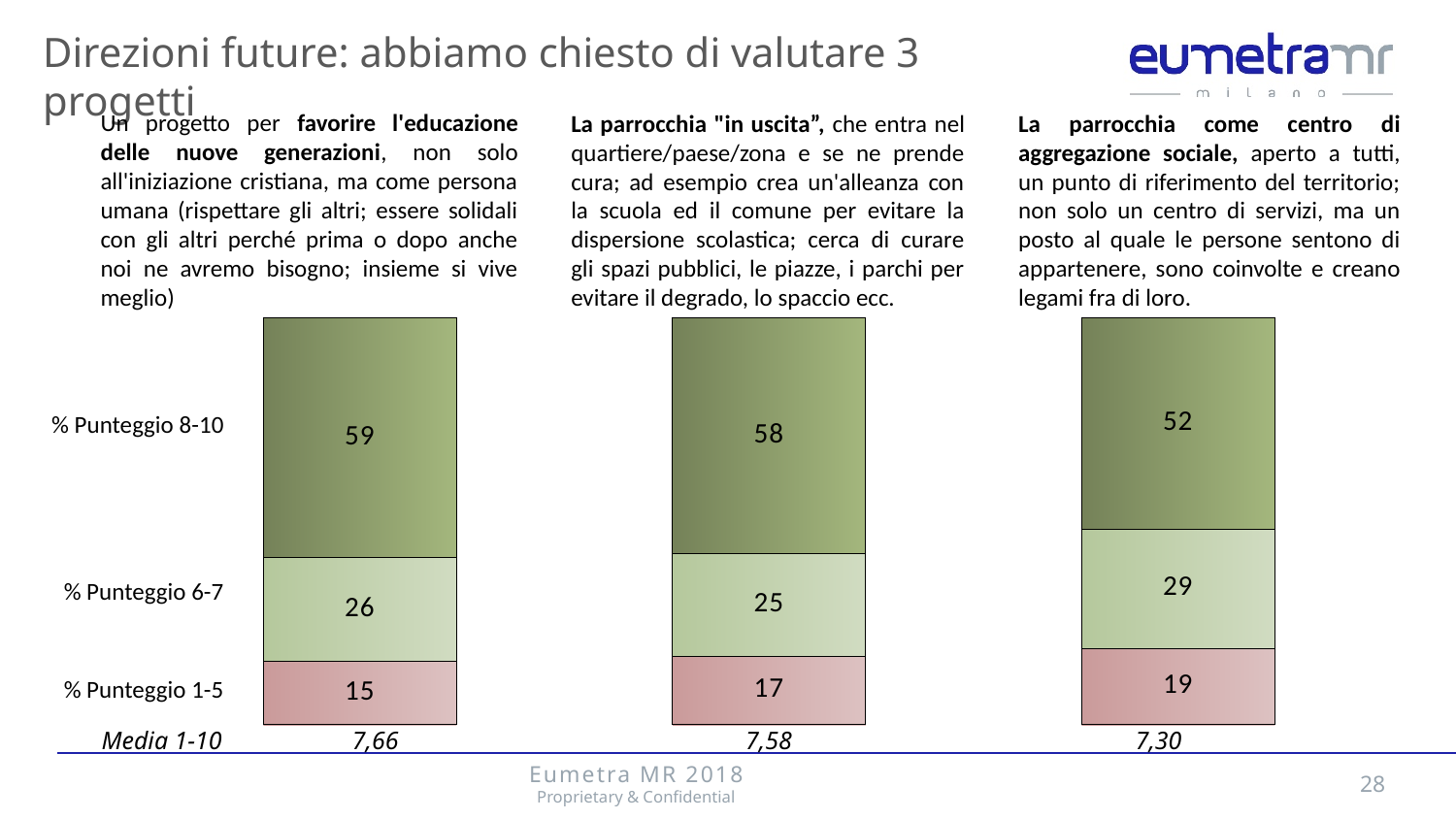
In the left chart, what is the difference between % Punteggio 8-10 and % Punteggio 6-7? 33 Across the three charts, which project has the highest % Punteggio 8-10? Un progetto per favorire l'educazione delle nuove generazioni (59) What is the difference between the % Punteggio 8-10 value in the left chart and in the right chart? 7 Is the % Punteggio 6-7 value larger in the right chart or in the middle chart? Right chart (29) How many segments does each stacked bar contain? 3 Across the three charts, which project has the lowest % Punteggio 1-5? Un progetto per favorire l'educazione delle nuove generazioni (15) What kind of chart is used to show the scores for each project? Stacked bar chart In the middle chart (La parrocchia "in uscita"), what is the value for % Punteggio 1-5? 17 In the left chart (progetto per favorire l'educazione delle nuove generazioni), what is the value for % Punteggio 8-10? 59 In the left chart, what is the total of the three stacked segments? 100 In the right chart (La parrocchia come centro di aggregazione sociale), what is the value for % Punteggio 6-7? 29 What colour is the % Punteggio 1-5 segment in the bars? Pink